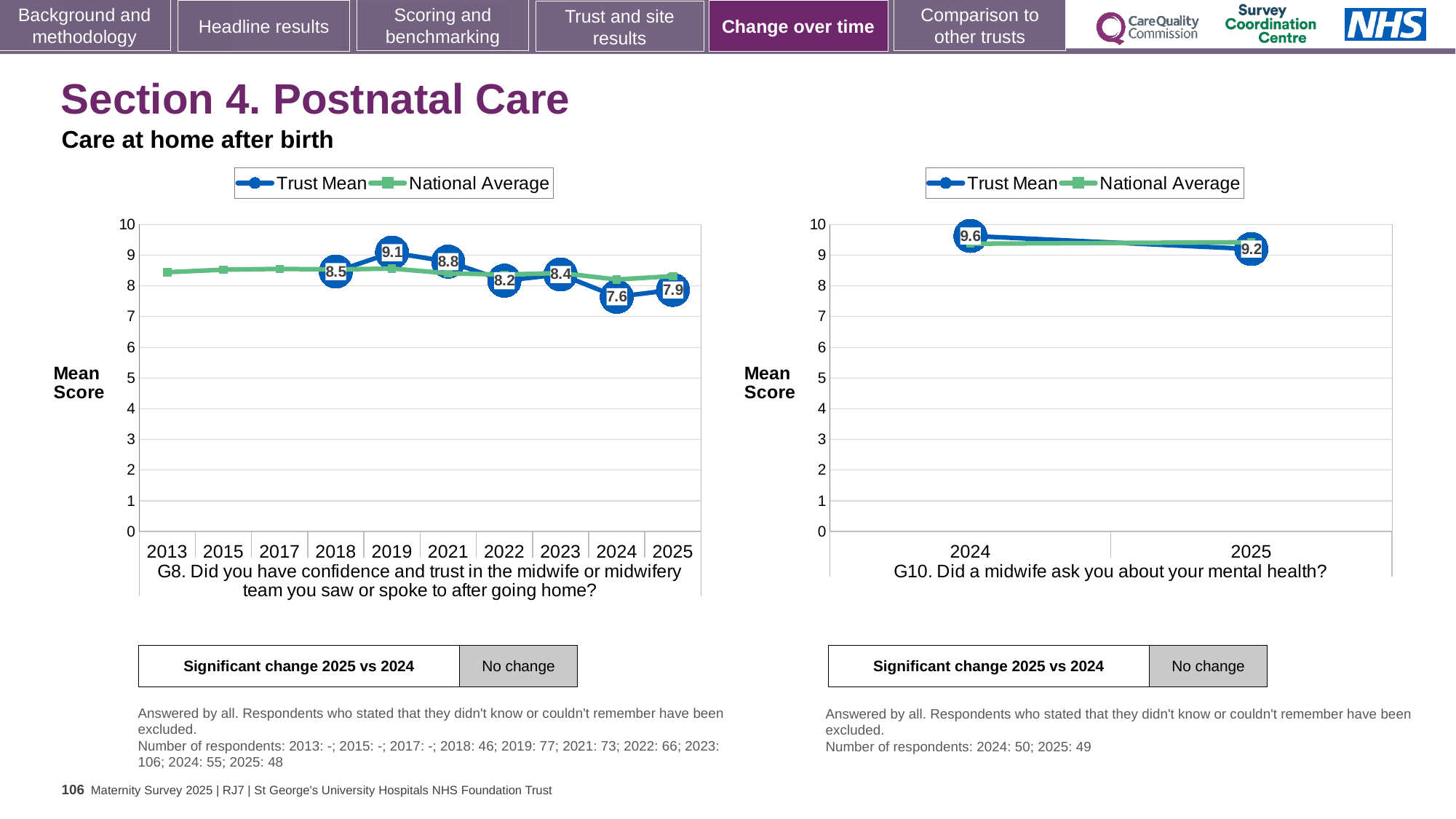
In the G10 chart on the right, what is the difference between the Trust Mean for 2024 and 2025? 0.4 In the G10 chart on the right, what is the Trust Mean for 2025? 9.2 How many years are shown on the x axis of the G8 chart on the left? 10 What kind of chart is the G10 chart on the right? Line chart In the G8 chart on the left, what is the difference between the Trust Mean for 2019 and 2025? 1.2 In the G8 chart on the left, is the Trust Mean higher in 2022 or 2023? 2023 In the G8 chart on the left, which year has the lowest Trust Mean? 2024 In the G8 chart on the left, what is the Trust Mean for 2024? 7.6 How many series does the legend of the G10 chart on the right list? 2 In the G8 chart on the left, what is the Trust Mean for 2019? 9.1 In the G8 chart on the left, which year has the highest Trust Mean? 2019 In the G8 chart on the left, is the National Average for 2013 greater or less than 8? greater